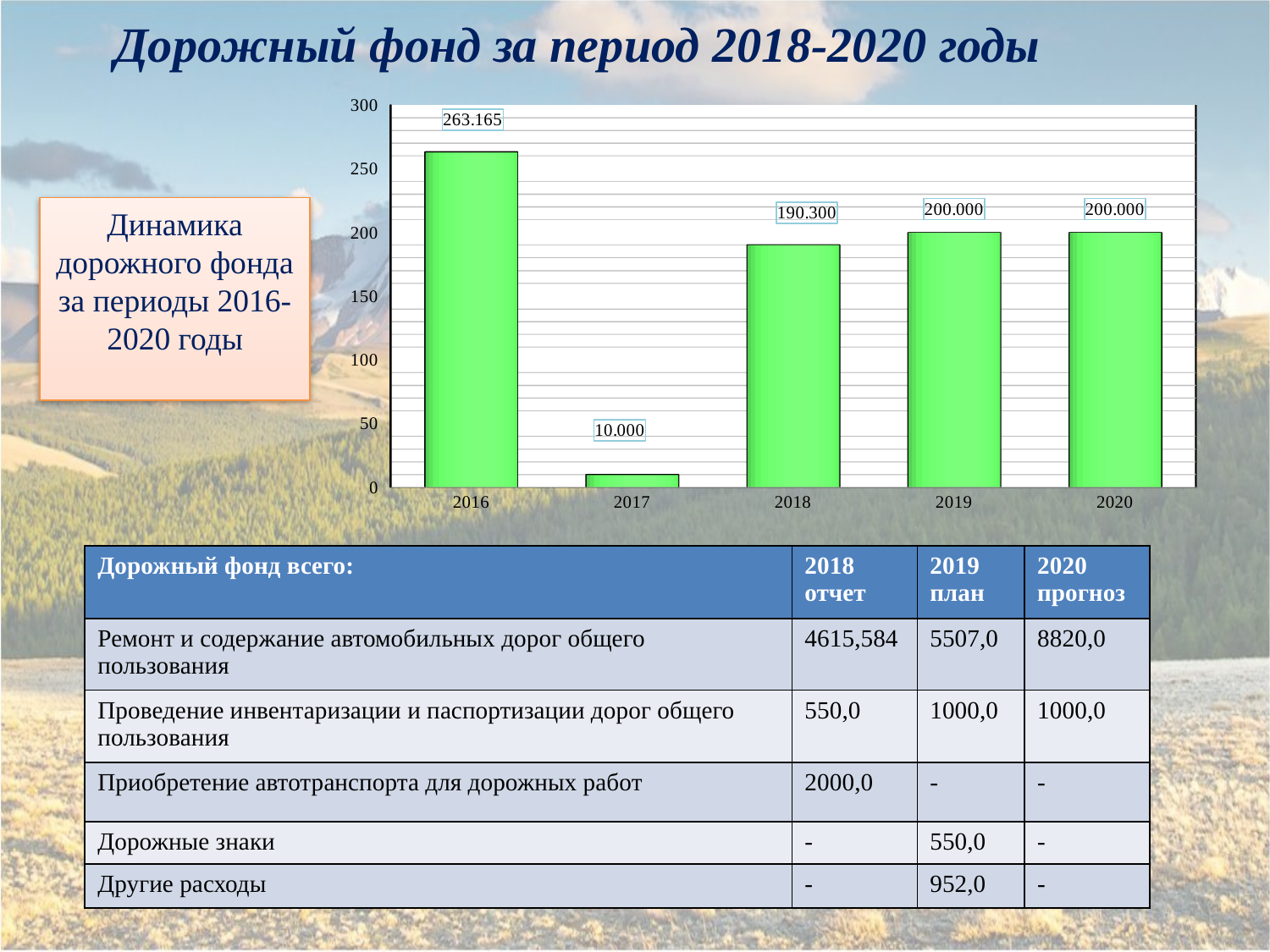
What kind of chart is shown on the slide? bar chart Is the value for 2018 in the bar chart greater or less than 150? greater What is the value for 2018 in the bar chart? 190.300 How many years are shown on the x axis of the bar chart? 5 What is the value for 2016 in the bar chart? 263.165 What is the difference between the values for 2016 and 2018 in the bar chart? 72.865 What is the value for 2017 in the bar chart? 10.000 What is the value for 2020 in the bar chart? 200.000 Which year has the lowest value in the bar chart? 2017 What is the difference between the values for 2019 and 2018 in the bar chart? 9.700 Which is larger in the bar chart, the value for 2016 or the value for 2019? 2016 Which year has the highest value in the bar chart? 2016